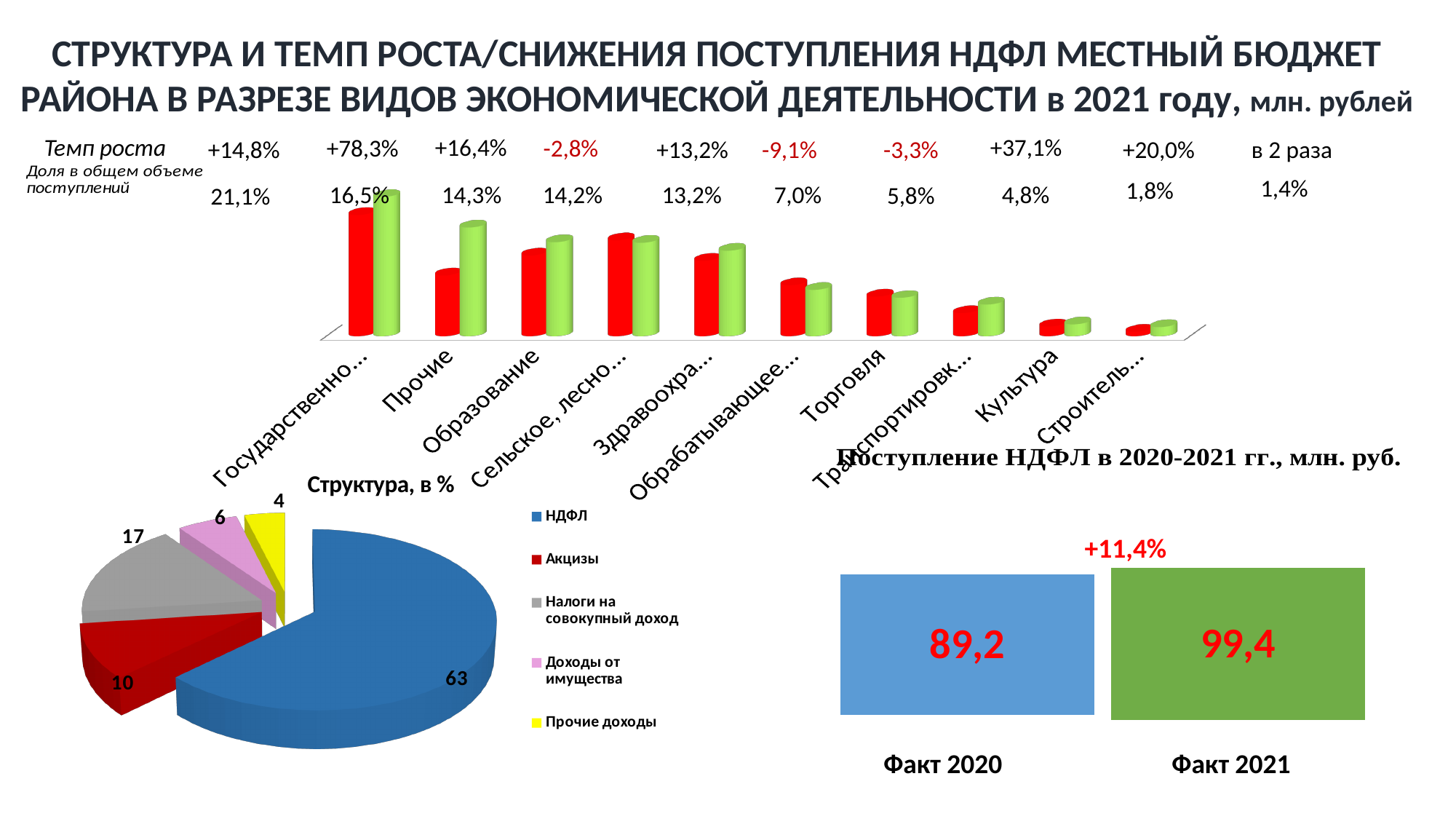
In the chart 'Поступление НДФЛ в 2020-2021 гг., млн. руб.', what is the difference between Факт 2021 and Факт 2020? 10,2 In the pie chart 'Структура, в %', what value is shown for Налоги на совокупный доход? 17 In the top bar chart, what growth rate (Темп роста) is printed for Прочие? +78,3% In the pie chart 'Структура, в %', what value is shown for НДФЛ? 63 In the pie chart 'Структура, в %', which is larger: Акцизы or Доходы от имущества? Акцизы In the pie chart 'Структура, в %', which category has the largest slice? НДФЛ In the top bar chart, how many categories are shown on the x axis? 10 In the chart 'Поступление НДФЛ в 2020-2021 гг., млн. руб.', what is the value for Факт 2021? 99,4 In the pie chart 'Структура, в %', how many entries does the legend list? 5 In the chart 'Поступление НДФЛ в 2020-2021 гг., млн. руб.', what percentage change is printed above the bars? +11,4% In the pie chart 'Структура, в %', which category has the smallest slice? Прочие доходы In the top bar chart, what share of total receipts (Доля в общем объеме поступлений) is printed for Образование? 14,3%